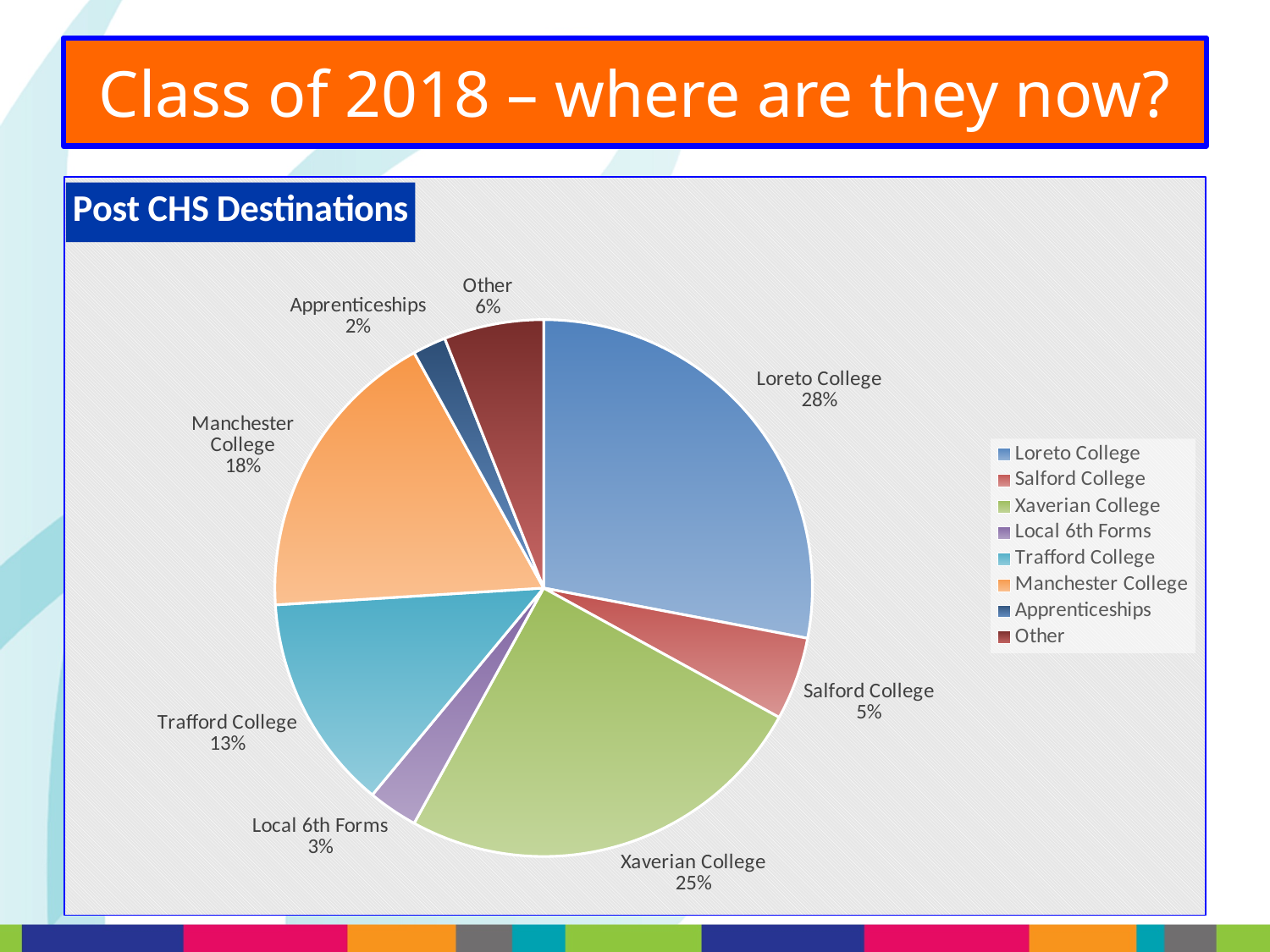
How many categories are shown in the pie chart? 8 What share of the pie does Loreto College have? 28% Which is larger, the share for Salford College or the share for Other? Other What is the title of the chart? Post CHS Destinations Which destination has the largest slice of the pie? Loreto College What is the combined percentage for Local 6th Forms and Apprenticeships? 5% What kind of chart is shown on the slide? Pie chart What is the value shown for Trafford College? 13% What is the value shown for Manchester College? 18% Which destination has the smallest slice of the pie? Apprenticeships How many entries does the legend list? 8 What is the difference between the Loreto College and Xaverian College percentages? 3%